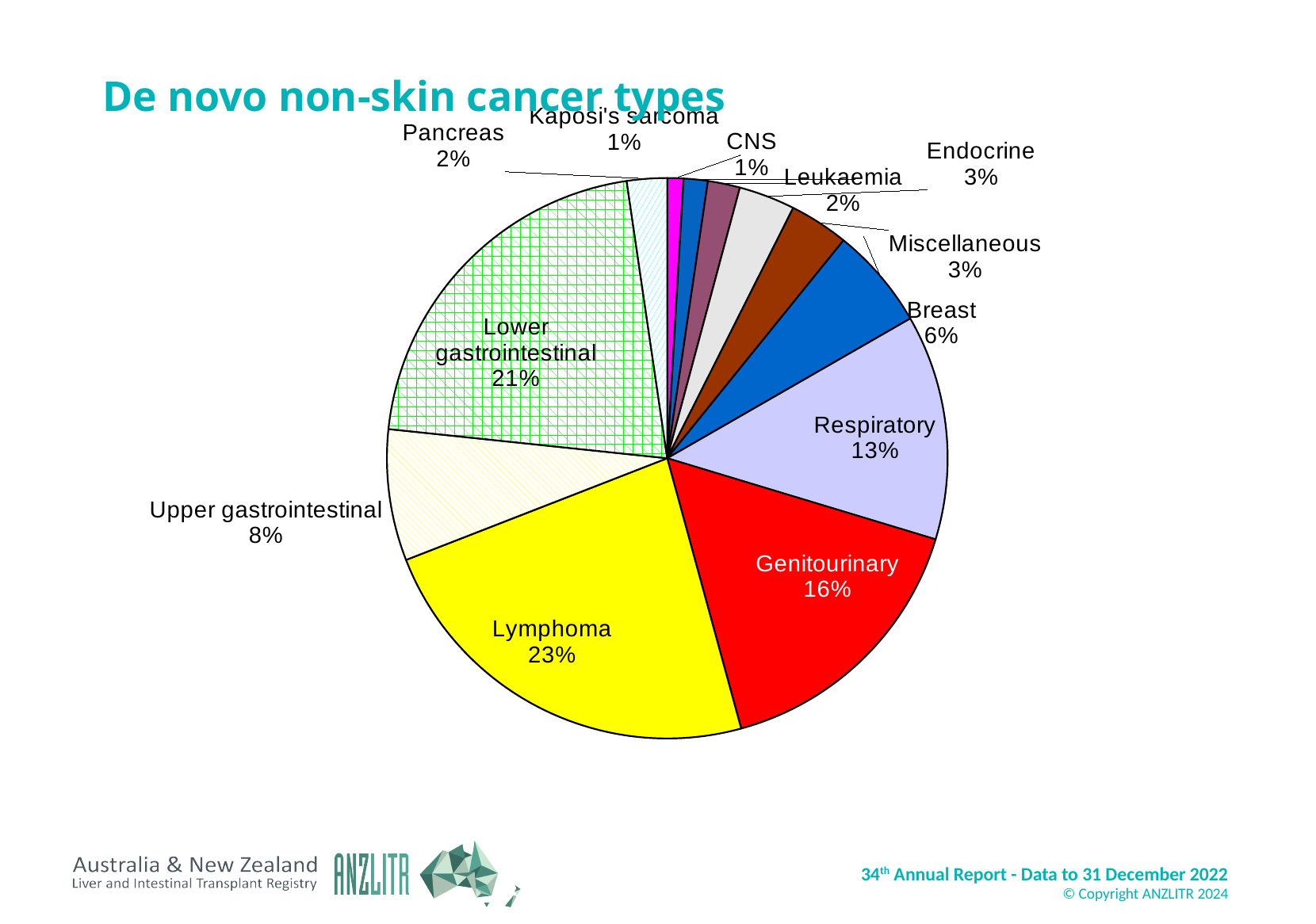
What is the value shown for Upper gastrointestinal? 8% What kind of chart is shown on the slide? Pie chart What share of the pie does Lymphoma represent? 23% What is the value shown for Endocrine? 3% What is the value shown for Respiratory? 13% Which is larger, the share for Breast or the share for Miscellaneous? Breast What is the title of the chart? De novo non-skin cancer types What share of the pie does Lower gastrointestinal represent? 21% What is the value shown for Genitourinary? 16% What is the difference between the Lymphoma share and the Genitourinary share? 7% Which cancer type has the largest slice of the pie? Lymphoma How many slices does the pie chart have? 12